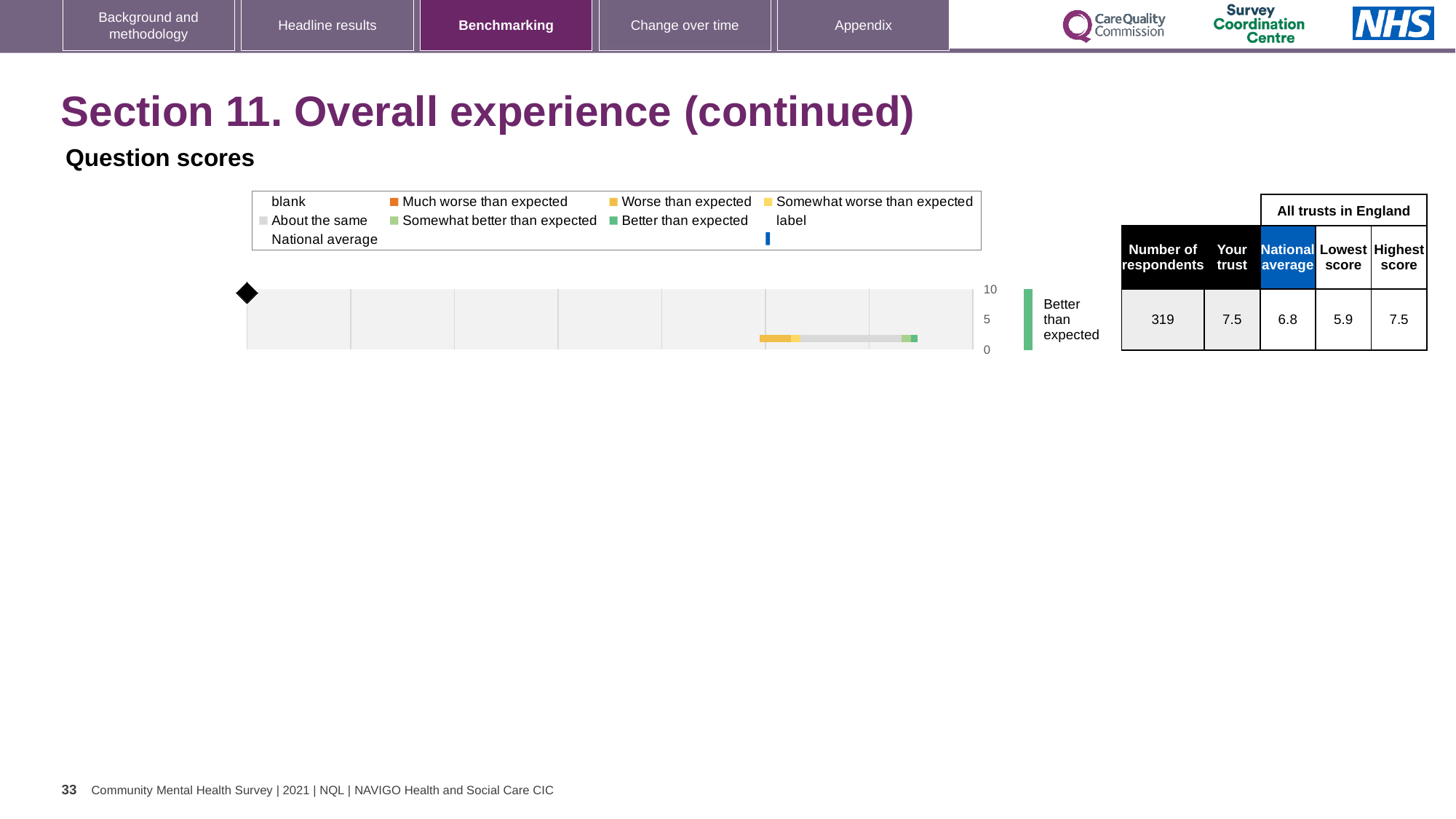
What is the highest value shown on the chart's axis? 10 Which is larger, the 'Your trust' score or the national average score? Your trust In the table beside the chart, what is the highest score among all trusts in England? 7.5 What kind of chart is shown under 'Question scores'? bar chart In the table beside the chart, what is the score for 'Your trust'? 7.5 In the table beside the chart, what is the lowest score among all trusts in England? 5.9 What is the difference between the 'Your trust' score and the national average score? 0.7 In the table beside the chart, what is the number of respondents? 319 What benchmark category label is shown next to the bar in the chart? Better than expected What colour represents 'Much worse than expected' in the chart legend? orange In the table beside the chart, what is the national average score? 6.8